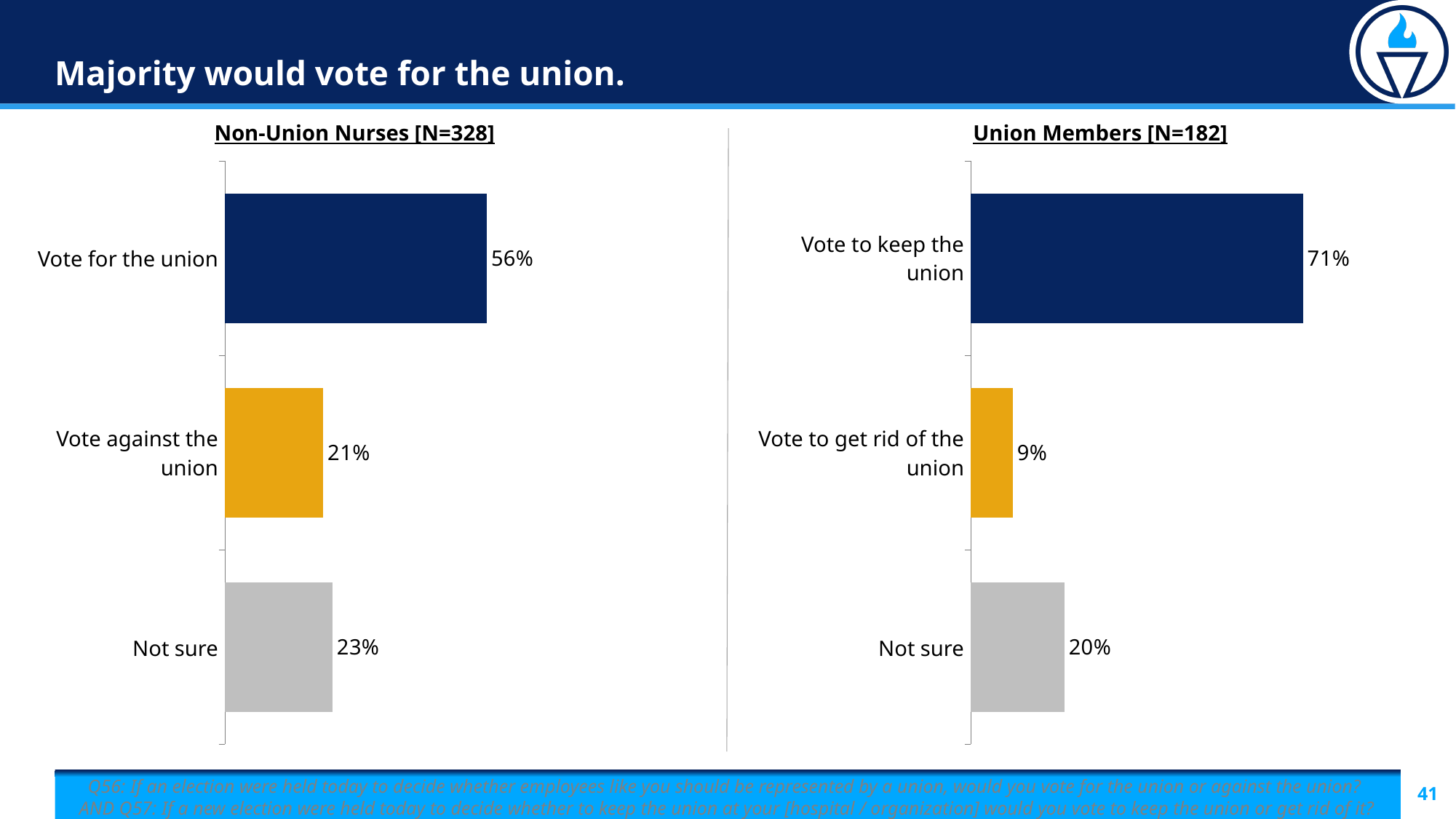
In the Union Members [N=182] chart, what is the difference between the share who would vote to keep the union and the share who are not sure? 51 percentage points Which is larger: the Not sure share in the Non-Union Nurses [N=328] chart or the Not sure share in the Union Members [N=182] chart? Non-Union Nurses [N=328] How many categories are shown in the Union Members [N=182] chart? 3 In the Non-Union Nurses [N=328] chart, what percentage would vote for the union? 56% In the Union Members [N=182] chart, what percentage are not sure? 20% In the Union Members [N=182] chart, which category has the lowest value? Vote to get rid of the union In the Union Members [N=182] chart, what percentage would vote to keep the union? 71% In the Non-Union Nurses [N=328] chart, what percentage would vote against the union? 21% In the Union Members [N=182] chart, what percentage would vote to get rid of the union? 9% What type of chart is the Non-Union Nurses [N=328] chart? Bar chart In the Non-Union Nurses [N=328] chart, what is the difference between the share who would vote for the union and the share who would vote against the union? 35 percentage points In the Non-Union Nurses [N=328] chart, which category has the highest value? Vote for the union